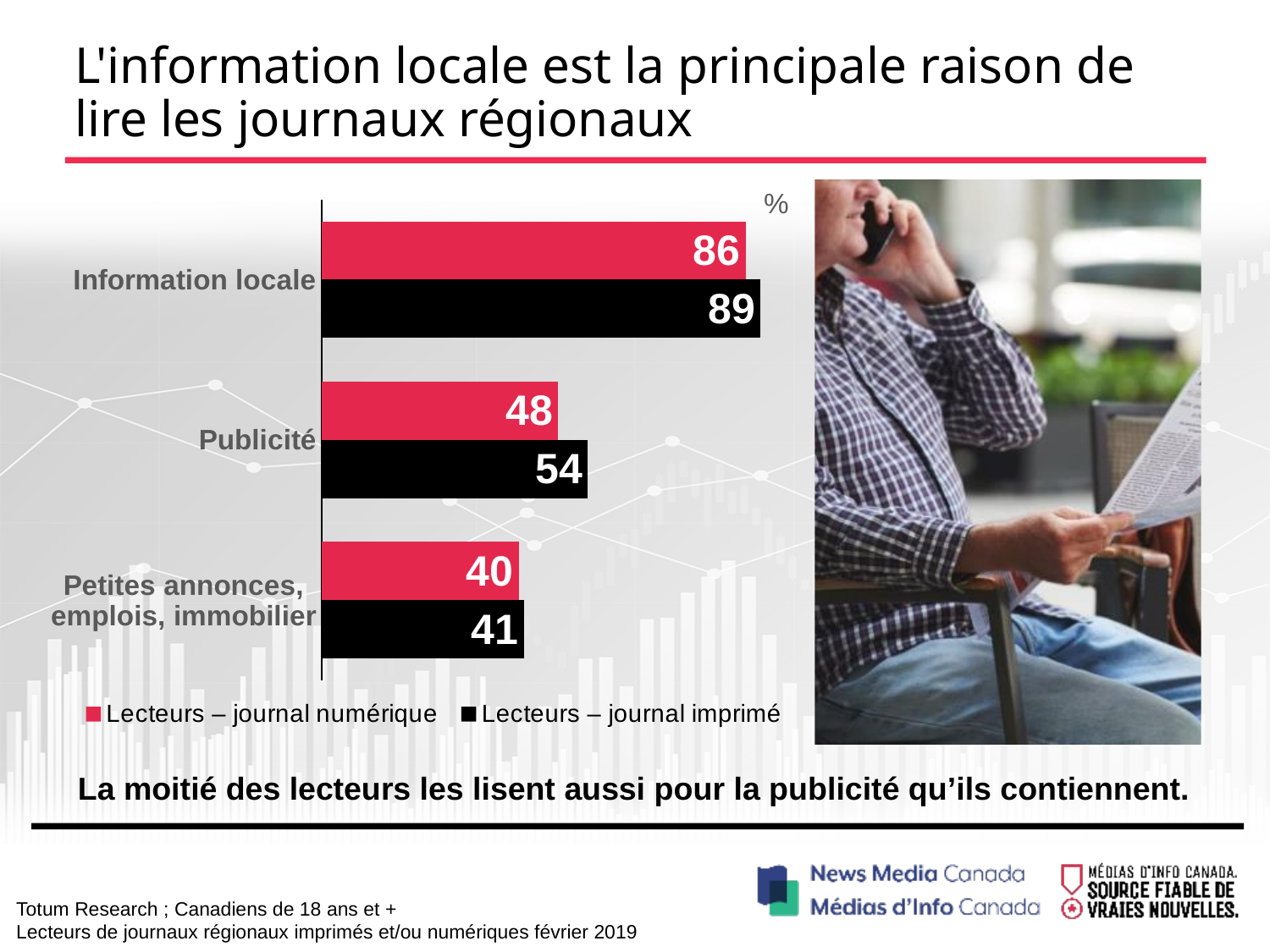
How many categories are shown in the chart? 3 Which category has the highest value for Lecteurs – journal imprimé? Information locale For Information locale, which series has the larger value: Lecteurs – journal numérique or Lecteurs – journal imprimé? Lecteurs – journal imprimé Which category has the lowest value for Lecteurs – journal numérique? Petites annonces, emplois, immobilier Which colour represents Lecteurs – journal imprimé in the chart? Black What is the value for Petites annonces, emplois, immobilier among Lecteurs – journal numérique? 40 What is the difference between Lecteurs – journal imprimé and Lecteurs – journal numérique for Publicité? 6 What kind of chart is shown on the slide? Bar chart What is the value for Publicité among Lecteurs – journal imprimé? 54 How many series does the legend list? 2 What is the value for Information locale among Lecteurs – journal imprimé? 89 What is the value for Information locale among Lecteurs – journal numérique? 86